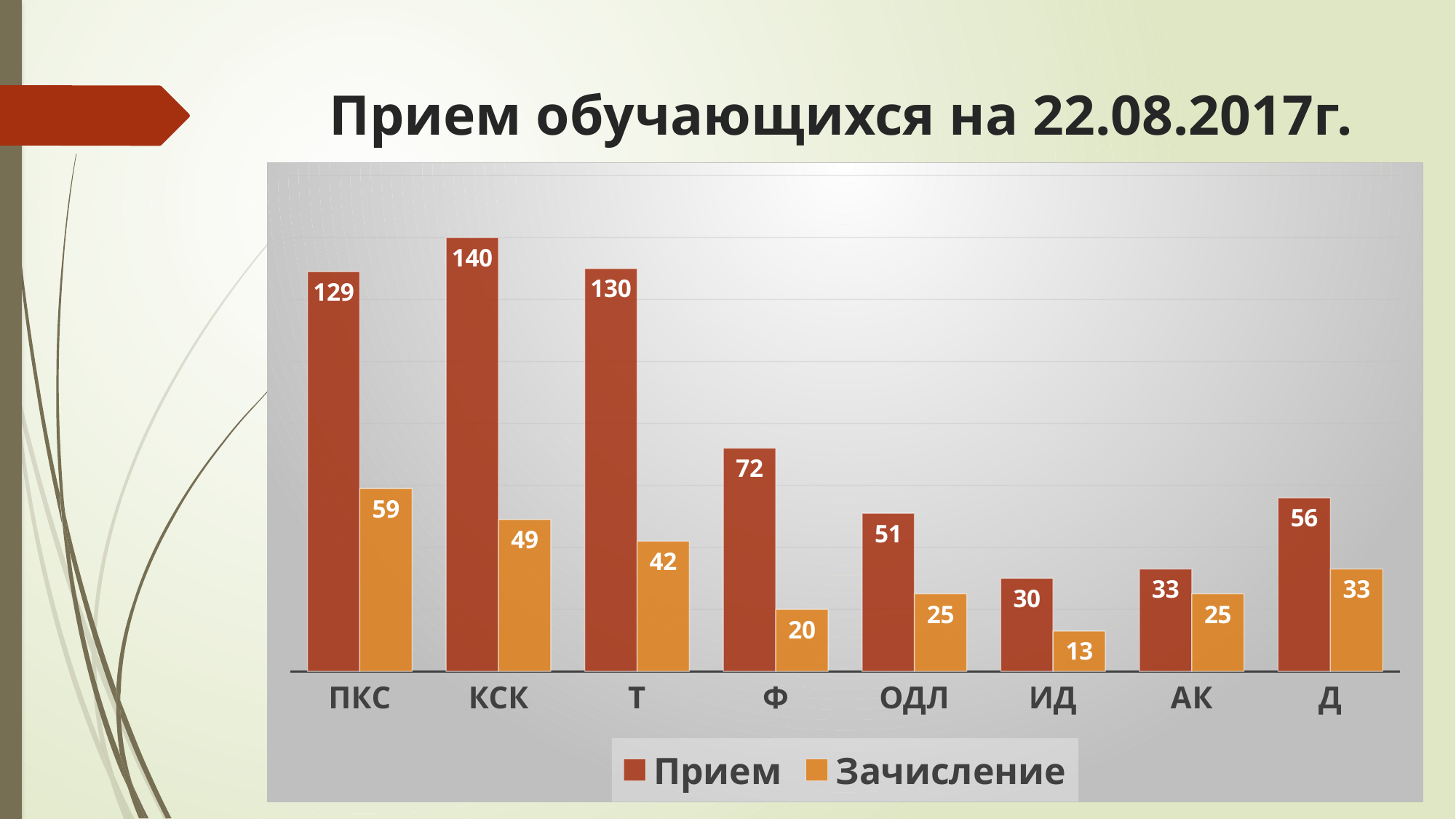
What kind of chart is shown on the slide? bar chart What is the Зачисление value for ПКС? 59 What colour are the Зачисление bars? orange Which is larger: the Прием value for Ф or the Прием value for Д? Ф Which category has the highest Прием value? КСК What is the Прием value for КСК? 140 How many categories are shown on the x axis? 8 Which category has the lowest Зачисление value? ИД What is the title of the slide? Прием обучающихся на 22.08.2017г. What is the Зачисление value for ИД? 13 What is the difference between Прием and Зачисление for Т? 88 How many series does the legend list? 2